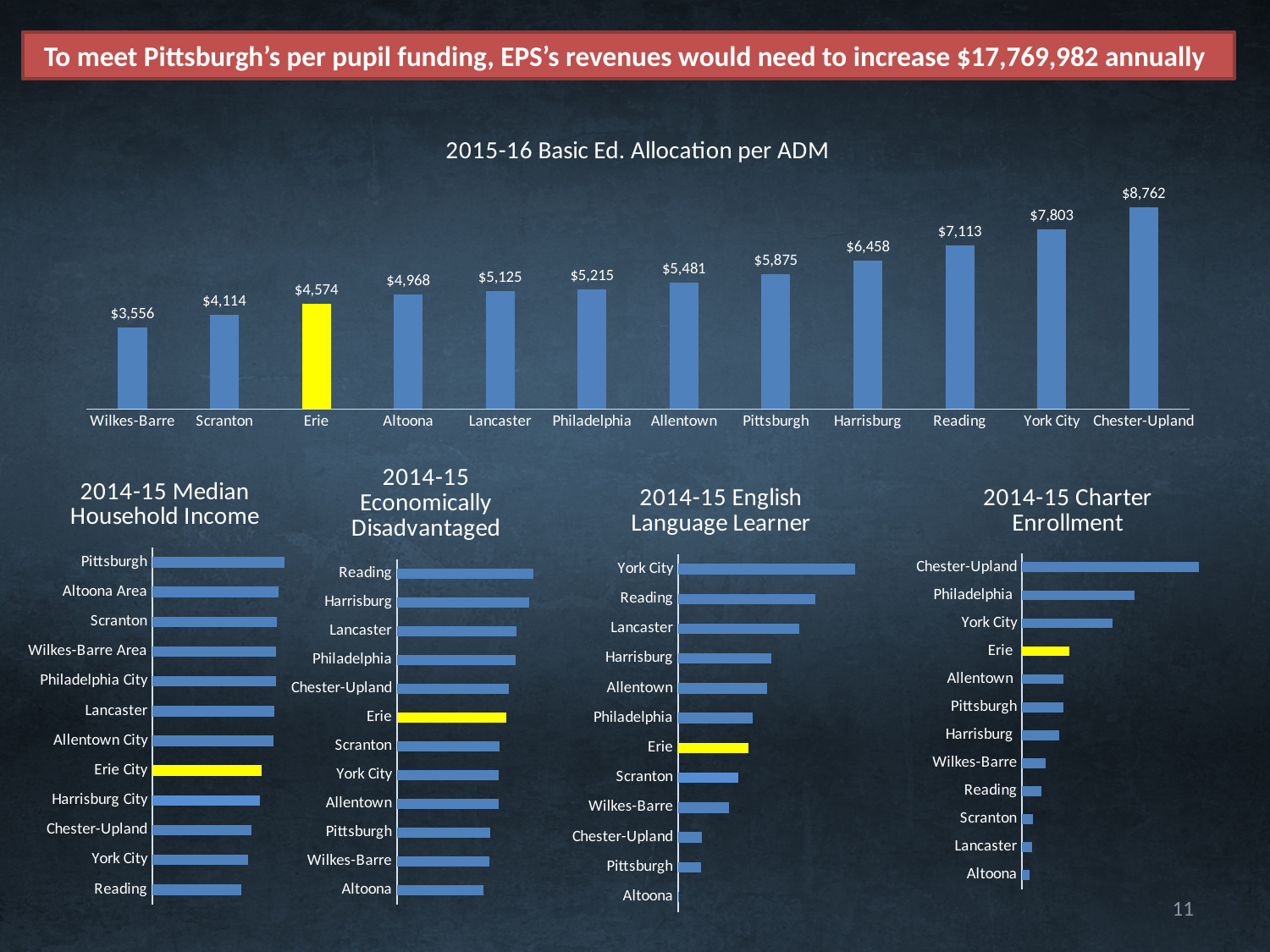
In the chart titled '2014-15 Charter Enrollment', which is larger, the value for Erie or the value for Pittsburgh? Erie In the chart titled '2015-16 Basic Ed. Allocation per ADM', what is the value for Pittsburgh? $5,875 In the chart titled '2015-16 Basic Ed. Allocation per ADM', what is the difference between the values for Pittsburgh and Erie? $1,301 In the chart titled '2014-15 English Language Learner', which category has the highest value? York City What kind of chart is the '2015-16 Basic Ed. Allocation per ADM' chart? bar chart In the chart titled '2015-16 Basic Ed. Allocation per ADM', how many categories are shown? 12 In the chart titled '2014-15 Economically Disadvantaged', which category has the lowest value? Altoona In the chart titled '2015-16 Basic Ed. Allocation per ADM', which category has the lowest value? Wilkes-Barre In the chart titled '2015-16 Basic Ed. Allocation per ADM', which category has the highest value? Chester-Upland In the chart titled '2015-16 Basic Ed. Allocation per ADM', what is the value for Erie? $4,574 In the chart titled '2015-16 Basic Ed. Allocation per ADM', do the values rise or fall from left to right? rise In the chart titled '2014-15 Median Household Income', which category has the highest value? Pittsburgh